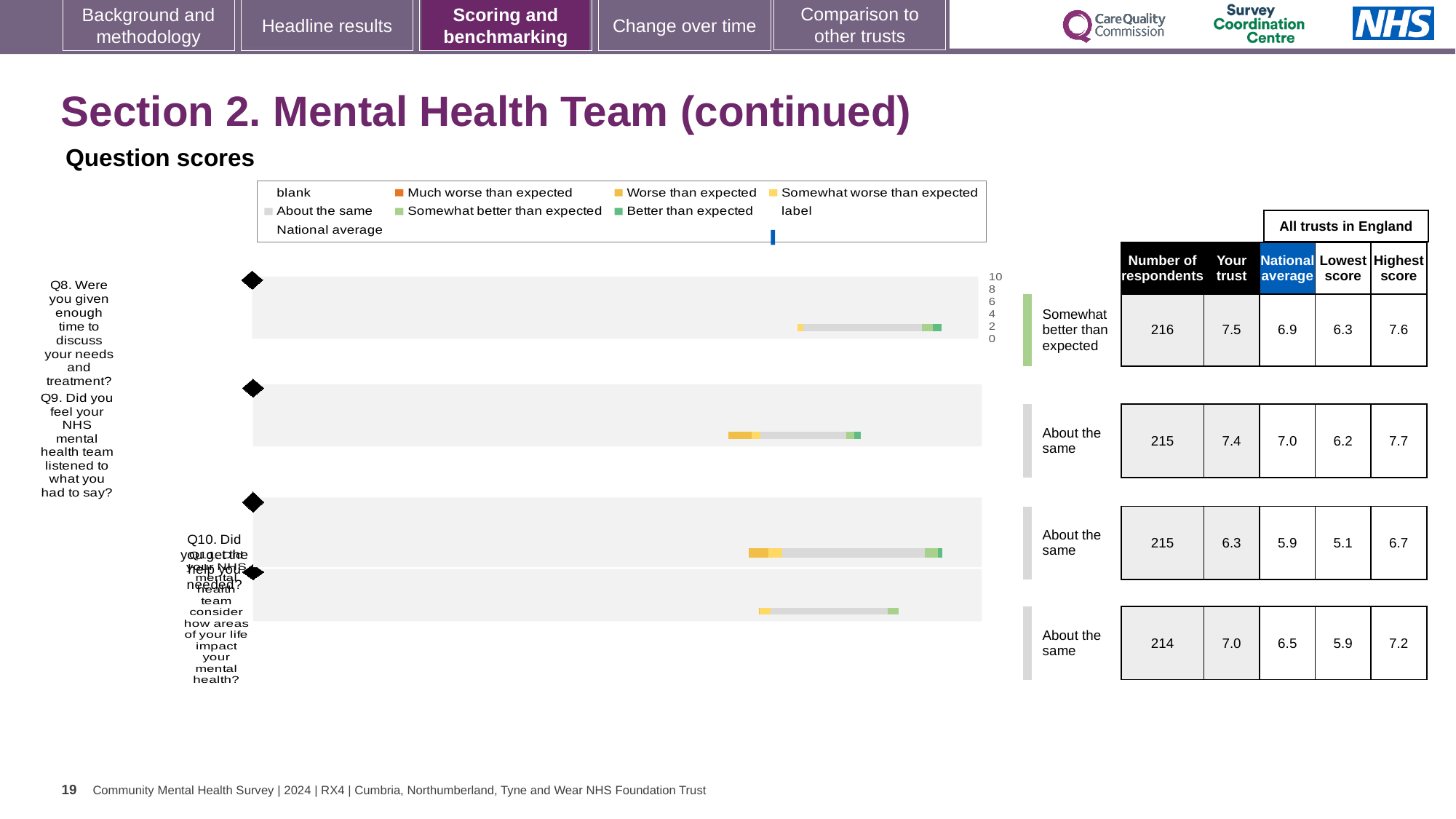
For Q9, which is larger: the 'Your trust' score or the national average? Your trust What is the national average score for Q9 (Did you feel your NHS mental health team listened to what you had to say?)? 7.0 What kind of chart is used to show the question scores on this slide? bar chart How many questions (rows) are plotted in the question scores chart? 4 Which question has the lowest 'Your trust' score? Q10 What is the title shown above the chart? Question scores Which question is rated 'Somewhat better than expected'? Q8 Which question has the highest 'Your trust' score? Q8 How many respondents answered Q10 (Did you get the help you needed?)? 215 In the table beside the chart, what is the 'Your trust' score for Q8 (Were you given enough time to discuss your needs and treatment?)? 7.5 What is the highest score across all trusts in England for Q11? 7.2 What is the difference between the 'Your trust' score and the national average for Q8? 0.6